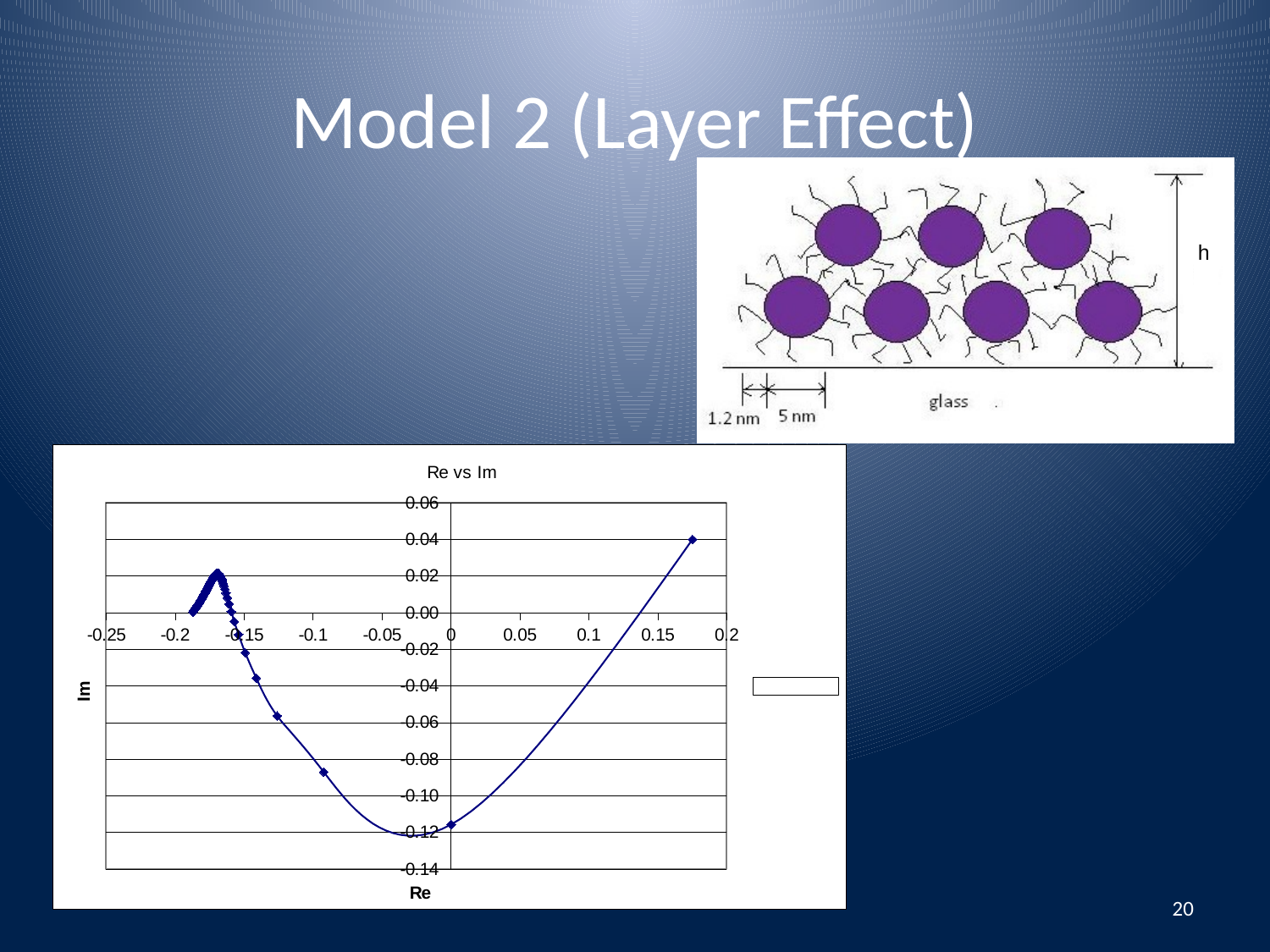
In the "Re vs Im" chart, does Im rise or fall as Re increases from -0.15 to 0? fall In the "Re vs Im" chart, does Im rise or fall as Re increases from 0 to 0.2? rise In the "Re vs Im" chart, is the Im value of the point near Re = -0.1 greater or less than -0.06? less In the "Re vs Im" chart, does the highest Im value occur at a positive or a negative Re value? positive What kind of chart is the "Re vs Im" chart? scatter chart In the "Re vs Im" chart, which is larger: the Im value at the rightmost point (near Re = 0.175) or the Im value at the point near Re = 0? the point near Re = 0.175 In the "Re vs Im" chart, is the lowest Im value reached by the curve greater or less than -0.10? less What is the title of the chart on the slide? Re vs Im What is the label of the horizontal axis of the "Re vs Im" chart? Re In the "Re vs Im" chart, is the Im value of the rightmost point (near Re = 0.175) greater or less than 0.02? greater